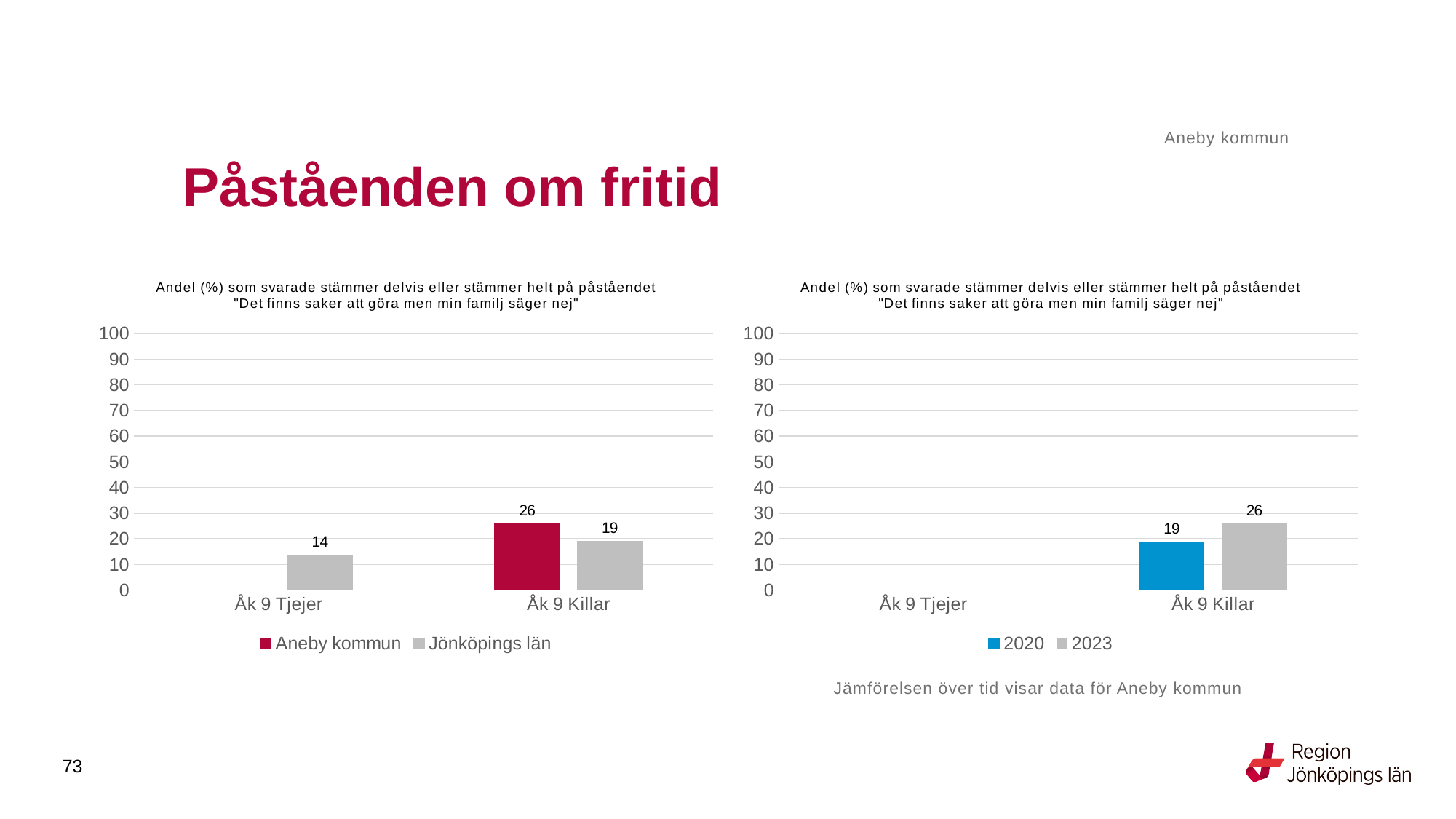
In the left chart, which is larger for Åk 9 Killar: Aneby kommun or Jönköpings län? Aneby kommun In the left chart, what is the value for Aneby kommun for Åk 9 Killar? 26 In the right chart, by how much did the value for Åk 9 Killar change from 2020 to 2023? 7 What kind of chart is the right chart? bar chart In the right chart, what is the value for 2020 for Åk 9 Killar? 19 In the left chart, what is the difference between Aneby kommun and Jönköpings län for Åk 9 Killar? 7 In the right chart, did the value for Åk 9 Killar rise or fall from 2020 to 2023? rise In the right chart, which years does the legend list? 2020 and 2023 In the left chart, how many series does the legend list? 2 In the right chart, what is the value for 2023 for Åk 9 Killar? 26 In the left chart, what is the value for Jönköpings län for Åk 9 Killar? 19 In the left chart, what is the value for Jönköpings län for Åk 9 Tjejer? 14